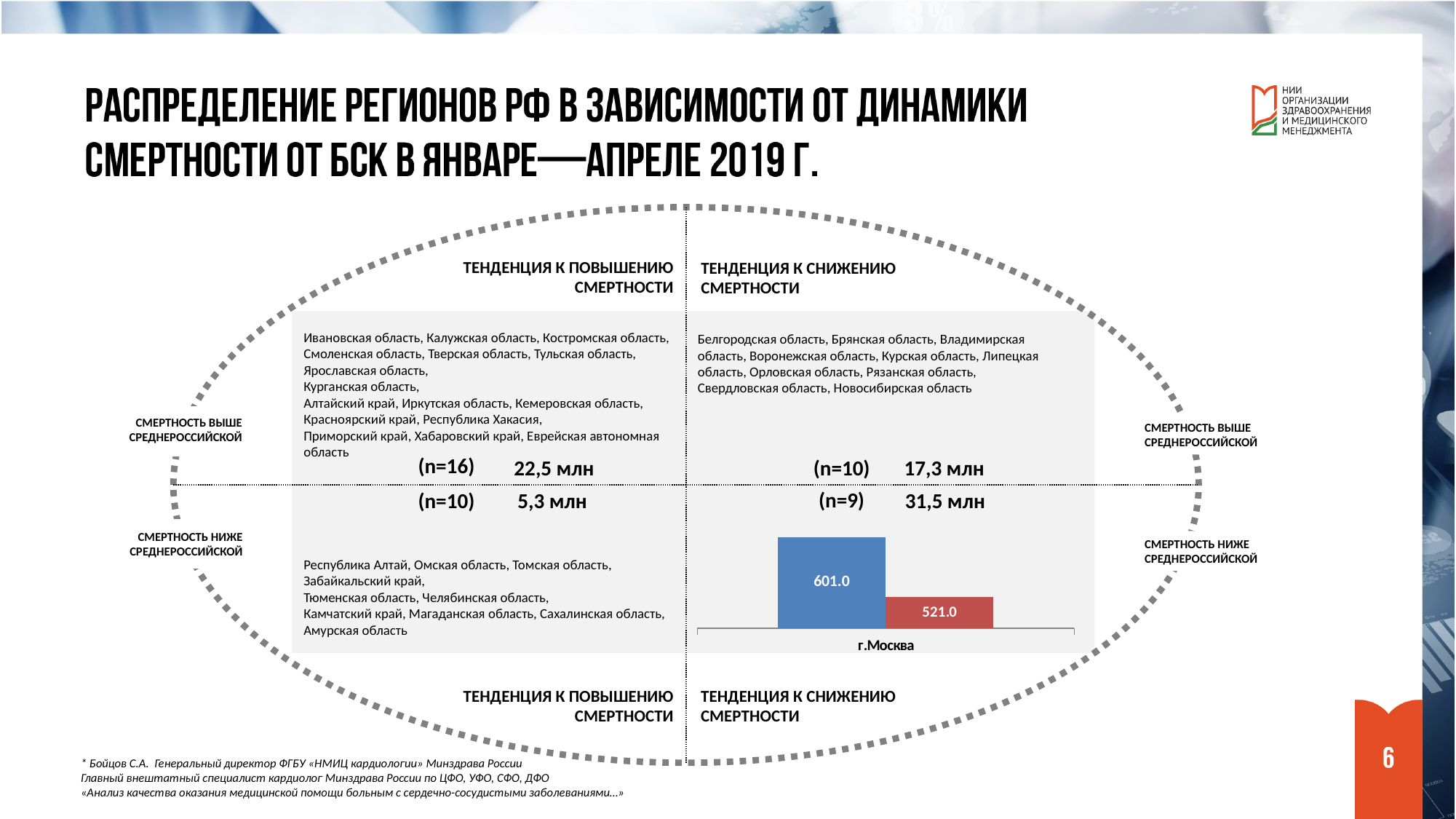
Do the bar values in the г.Москва chart rise or fall from left to right? fall What value is shown on the red bar in the bar chart for г.Москва? 521.0 What value is shown on the blue bar in the bar chart for г.Москва? 601.0 In the г.Москва chart, is the value 601.0 larger or smaller than 521.0? larger What kind of chart is shown in the lower-right quadrant of the slide? bar chart What is the category label printed under the bars in the small chart? г.Москва How many bars are plotted in the г.Москва chart? 2 What is the difference between the blue bar (601.0) and the red bar (521.0) in the г.Москва chart? 80.0 Which bar in the г.Москва chart has the lower value, the blue one or the red one? the red one Which bar in the г.Москва chart has the higher value, the blue one or the red one? the blue one What colours are the two bars in the г.Москва chart? blue and red